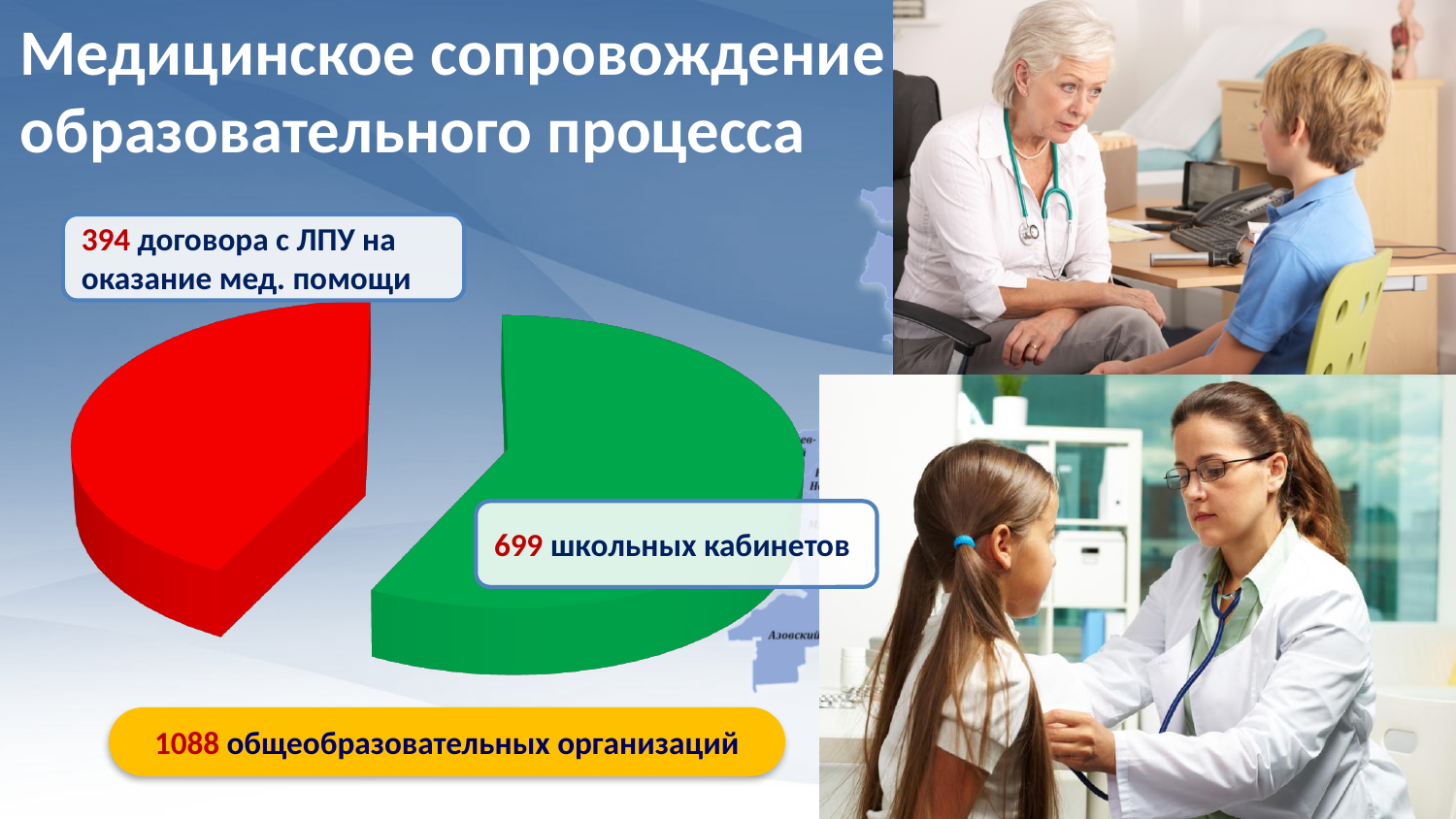
What colour is the slice representing договора с ЛПУ на оказание мед. помощи? red Which slice of the pie chart is the smallest? договора с ЛПУ на оказание мед. помощи What colour is the slice representing школьных кабинетов? green What is the difference between the number of школьных кабинетов (699) and the number of договора с ЛПУ (394)? 305 Which is larger: the number of школьных кабинетов or the number of договора с ЛПУ? школьных кабинетов What kind of chart is shown on the slide? pie chart What value is shown for the slice labelled "школьных кабинетов"? 699 What value is shown for the slice labelled "договора с ЛПУ на оказание мед. помощи"? 394 Which slice of the pie chart is the largest? школьных кабинетов How many slices does the pie chart have? 2 What number of общеобразовательных организаций is stated on the slide? 1088